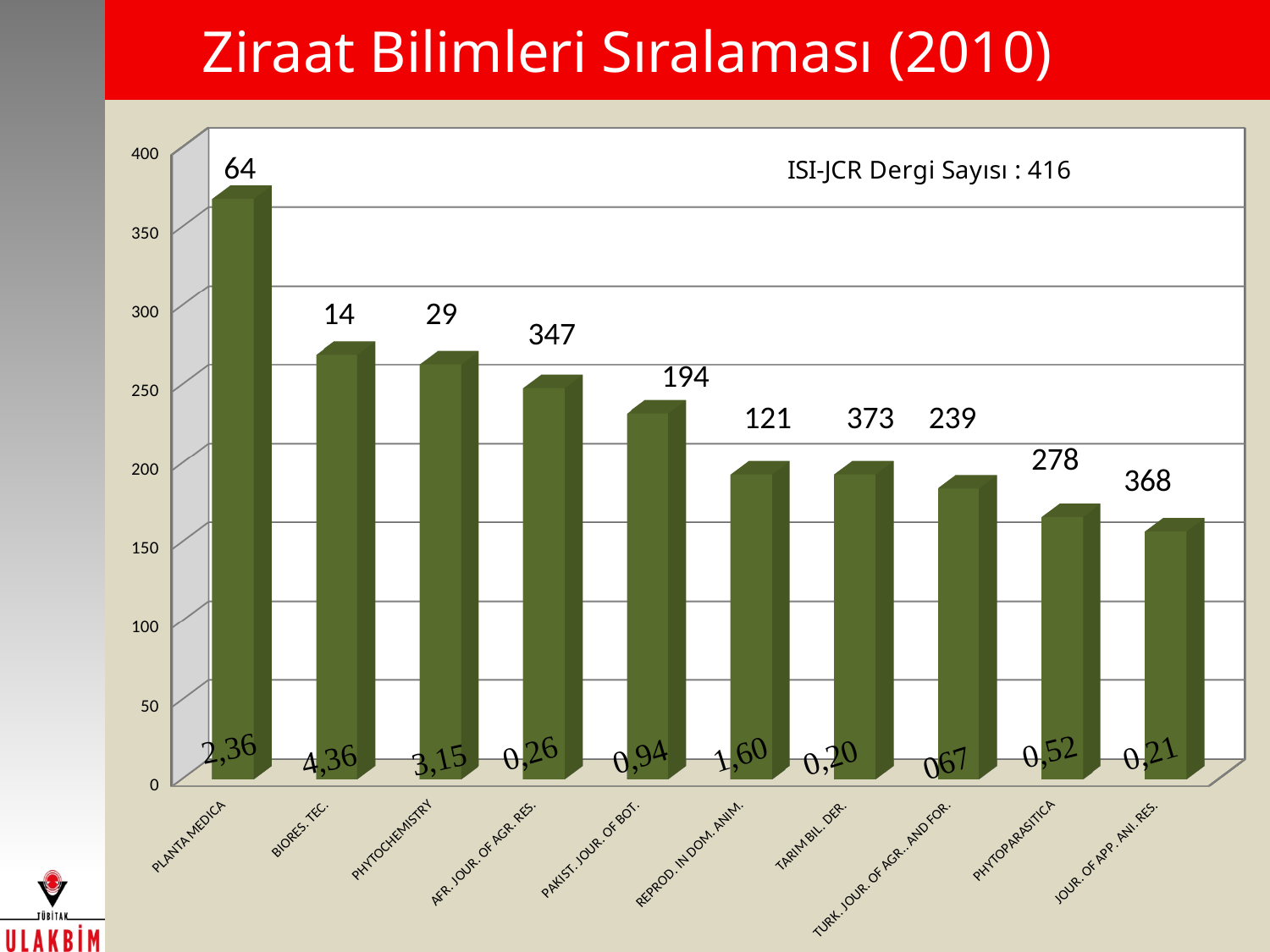
What kind of chart is shown on the slide? bar chart Do the bar heights rise or fall from left to right along the x axis? fall What is the ISI-JCR Dergi Sayısı value shown in the chart area? 416 Is the bar for PAKIST. JOUR. OF BOT. greater or less than 250? less How many bars (categories) does the chart show? 10 Which category has the shortest bar? JOUR. OF APP. ANI. RES. Which category has the tallest bar? PLANTA MEDICA What number is printed at the base of the bar for PLANTA MEDICA? 2,36 Is the bar for TURK. JOUR. OF AGR.. AND FOR. greater or less than 200? less Which bar is taller, PLANTA MEDICA or BIORES. TEC.? PLANTA MEDICA Is the bar for PLANTA MEDICA greater or less than 350? greater What number is printed above the bar for PHYTOCHEMISTRY? 29